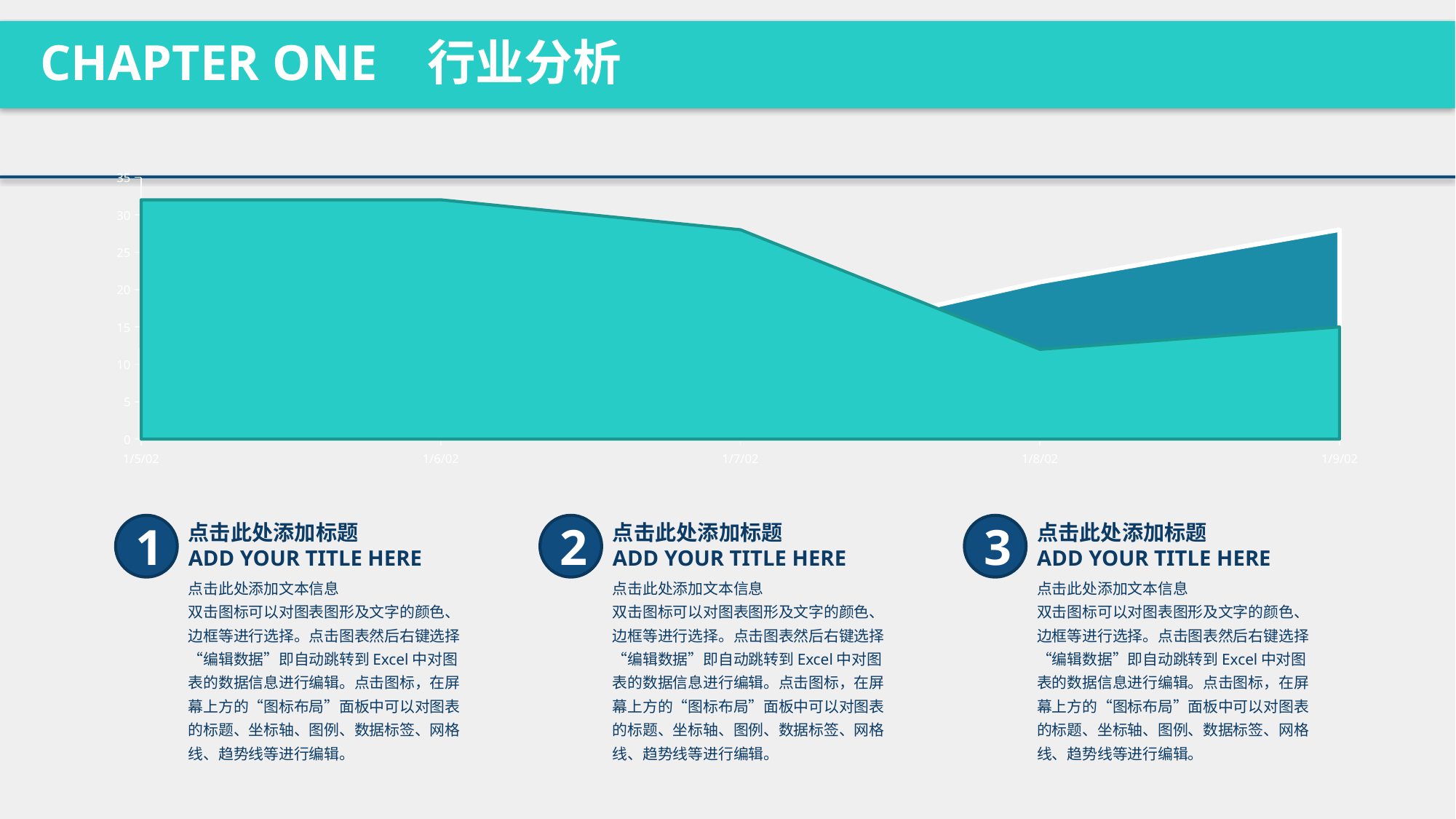
Is the value of the teal area at 1/8/02 greater or less than 15? less Does the teal area rise or fall from 1/8/02 to 1/9/02? rise Is the value of the teal area at 1/9/02 greater or less than 20? less Is the value of the teal area at 1/5/02 greater or less than 30? greater How many dates are labelled along the x axis of the chart? 5 Does the teal area rise or fall from 1/6/02 to 1/8/02? fall What is the highest tick value shown on the y axis of the chart? 35 At which date does the teal area reach its lowest value? 1/8/02 Which is larger for the teal area: the value at 1/7/02 or the value at 1/8/02? 1/7/02 What kind of chart is shown on the slide? area chart What is the first date label on the x axis of the chart? 1/5/02